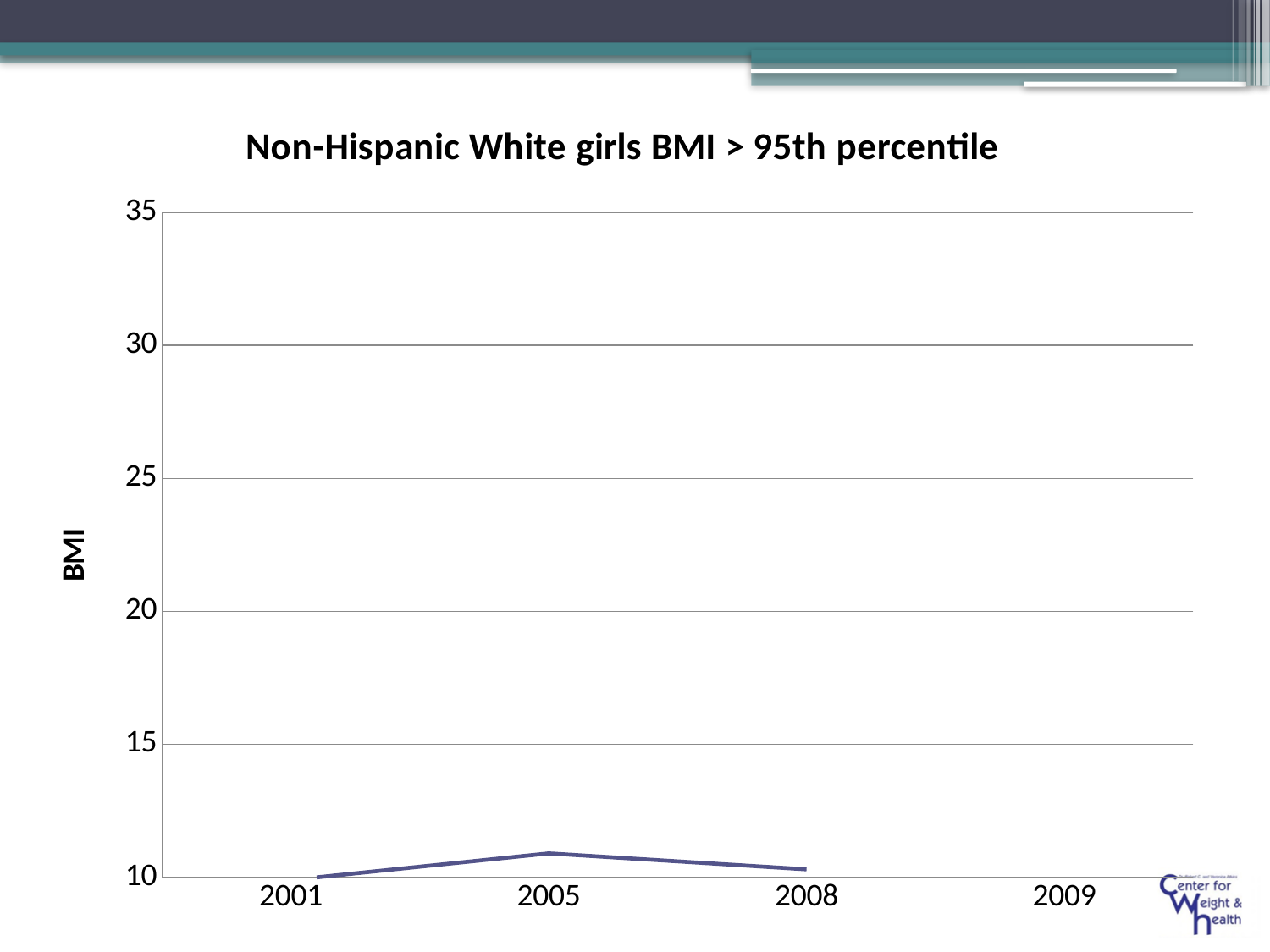
What is the highest value shown on the y axis? 35 What is the label on the vertical axis of the chart? BMI Which is larger, the plotted value for 2005 or for 2001? 2005 Which year has the highest plotted BMI value? 2005 What is the title of the chart? Non-Hispanic White girls BMI > 95th percentile Is the plotted value for 2008 greater or less than 20? less How many years are labelled on the x axis of the chart? 4 Does the line rise or fall between 2005 and 2008? fall Is the plotted value for 2005 greater or less than 15? less Does the line rise or fall between 2001 and 2005? rise What kind of chart is shown on the slide? line chart